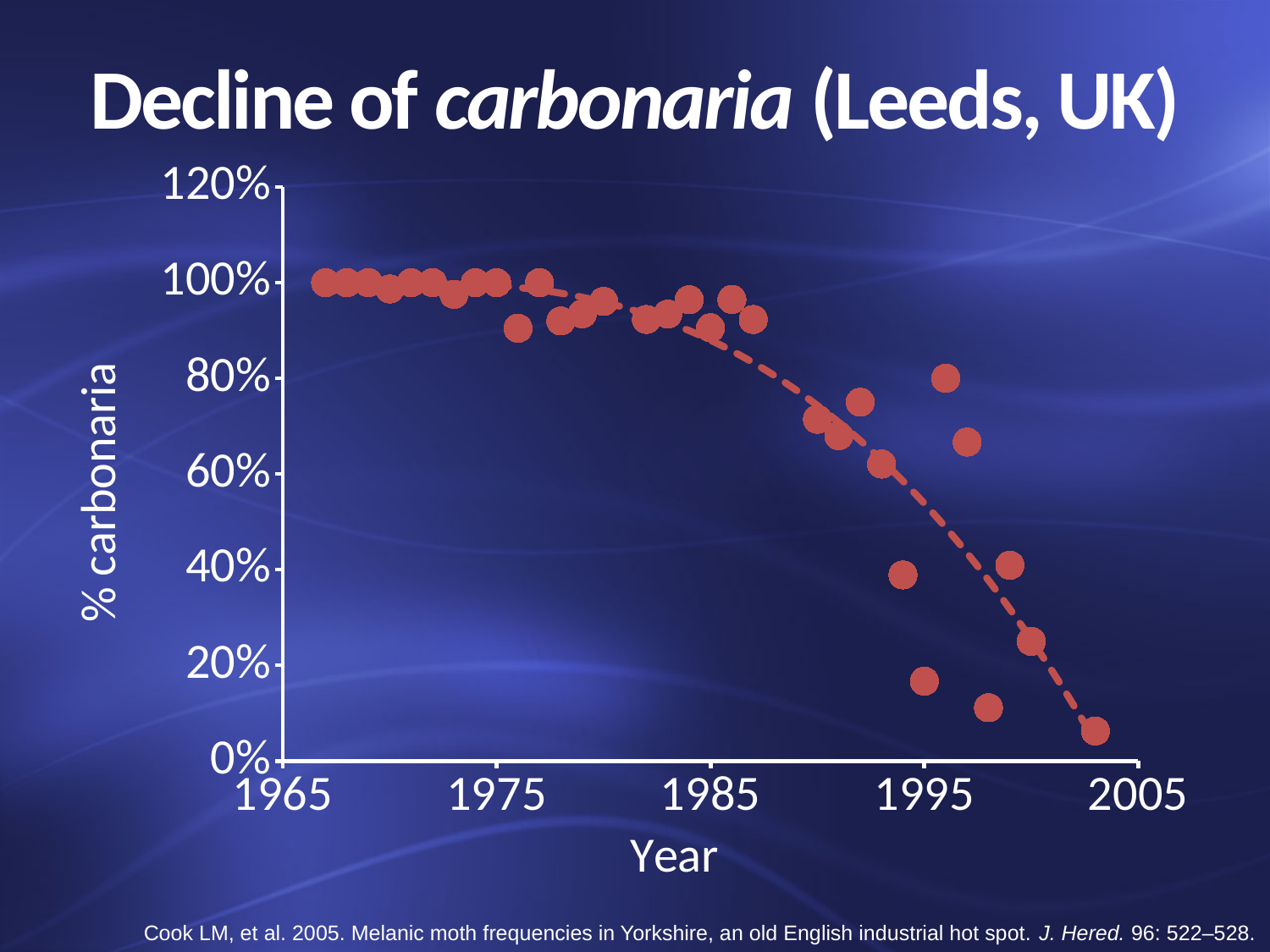
What kind of chart is shown on the slide? scatter chart Do the plotted values rise or fall as the year increases along the x axis? fall What is the title of the chart? Decline of carbonaria (Leeds, UK) Is the value for the last plotted point, near 2003, greater or less than 20%? less Which is larger, the value plotted near 1975 or the value plotted near 2000? the value near 1975 What is the highest value shown on the y axis of the chart? 120% Is the value for the point plotted at about 1985 greater or less than 80%? greater Is the value for the earliest plotted point, near 1967, greater or less than 80%? greater What is the label on the y axis of the chart? % carbonaria